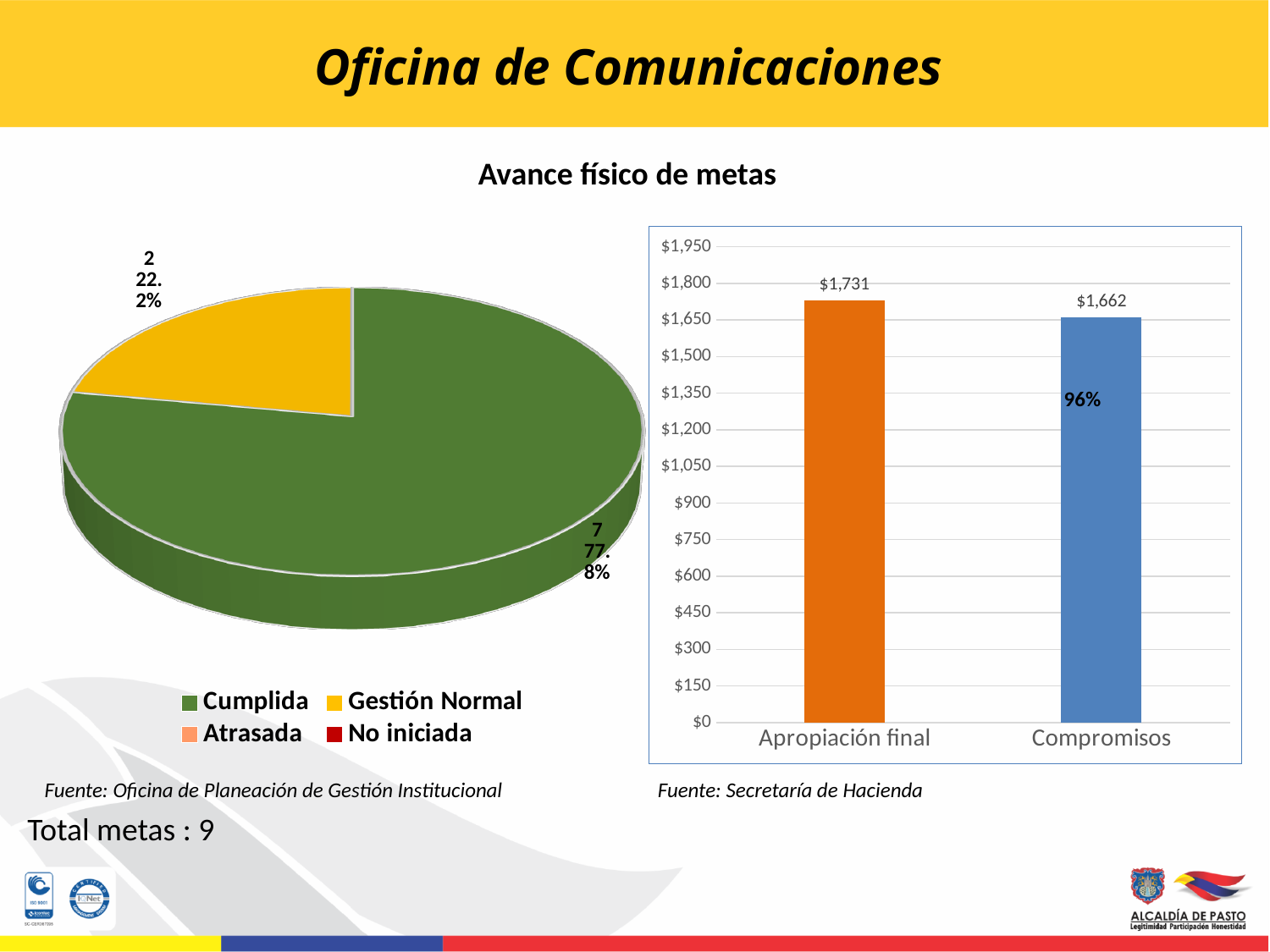
In the pie chart on the left, what share of the pie does the Cumplida slice represent? 77.8% What kind of chart is the chart on the left of the slide? pie chart In the pie chart on the left, what share of the pie does the Gestión Normal slice represent? 22.2% In the pie chart on the left, which category has the largest slice? Cumplida In the bar chart on the right, what is the difference between Apropiación final and Compromisos? $69 In the bar chart on the right, what is the value for Compromisos? $1,662 In the pie chart on the left, how many metas are labelled as Gestión Normal? 2 In the pie chart on the left, how many metas are labelled as Cumplida? 7 What kind of chart is the chart on the right of the slide? bar chart In the bar chart on the right, what is the value for Apropiación final? $1,731 How many entries does the legend of the pie chart on the left list? 4 In the bar chart on the right, which is larger, Apropiación final or Compromisos? Apropiación final